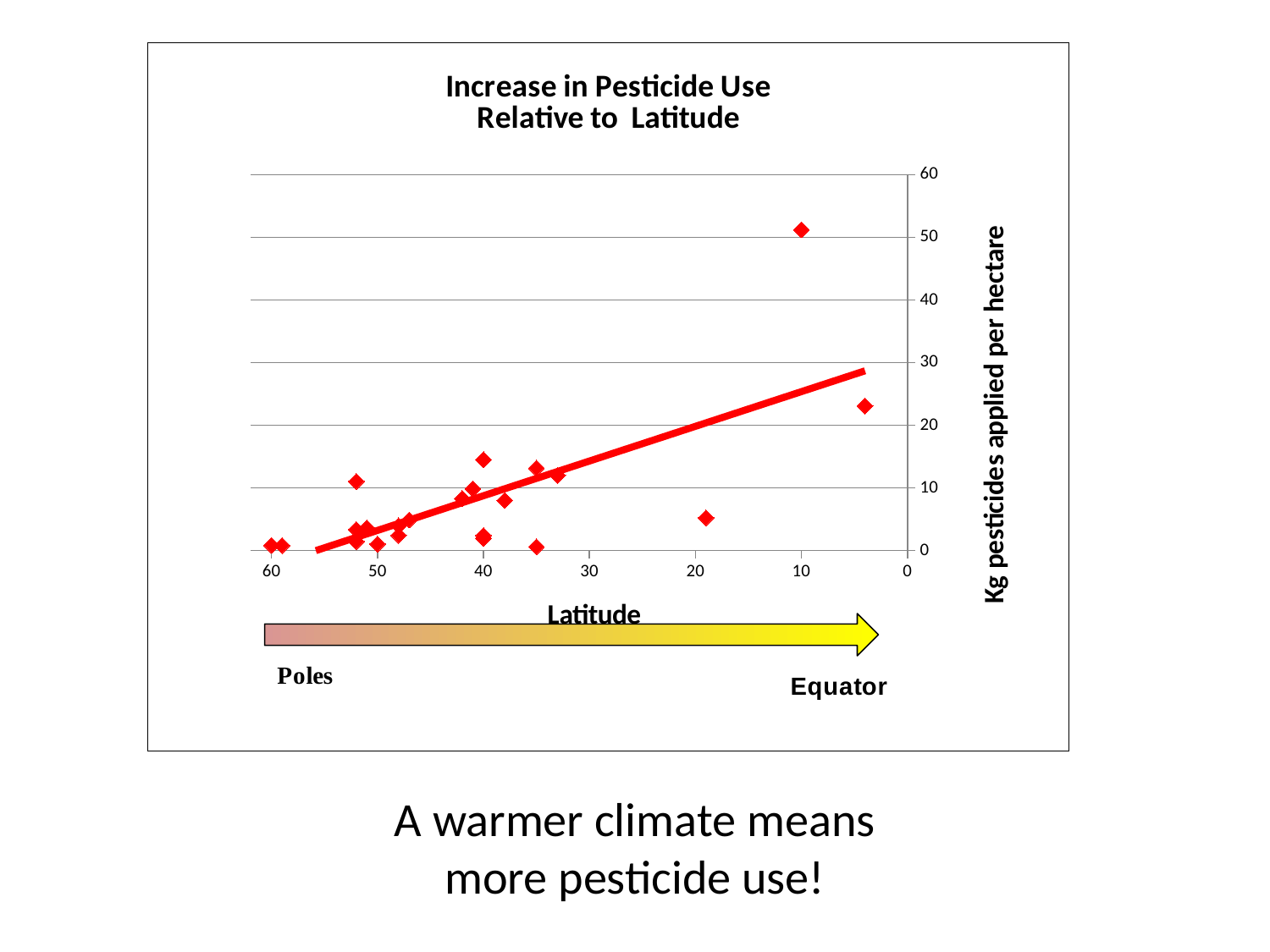
What kind of chart is shown on the slide? scatter chart Is the value of the data point near latitude 4 greater or less than 20 kg per hectare? greater Is the value of the data point near latitude 19 greater or less than 10 kg per hectare? less According to the trend line, do pesticide values rise or fall as latitude decreases toward the equator (moving left to right along the x axis)? rise What is the label of the vertical axis? Kg pesticides applied per hectare Is the value of the data point near latitude 52 that lies above the trend line greater or less than 10 kg per hectare? greater What is the title of the chart? Increase in Pesticide Use Relative to Latitude Which data point has the highest pesticide value: the one at latitude 10 or the one at latitude 4? the one at latitude 10 What is the maximum value shown on the vertical axis? 60